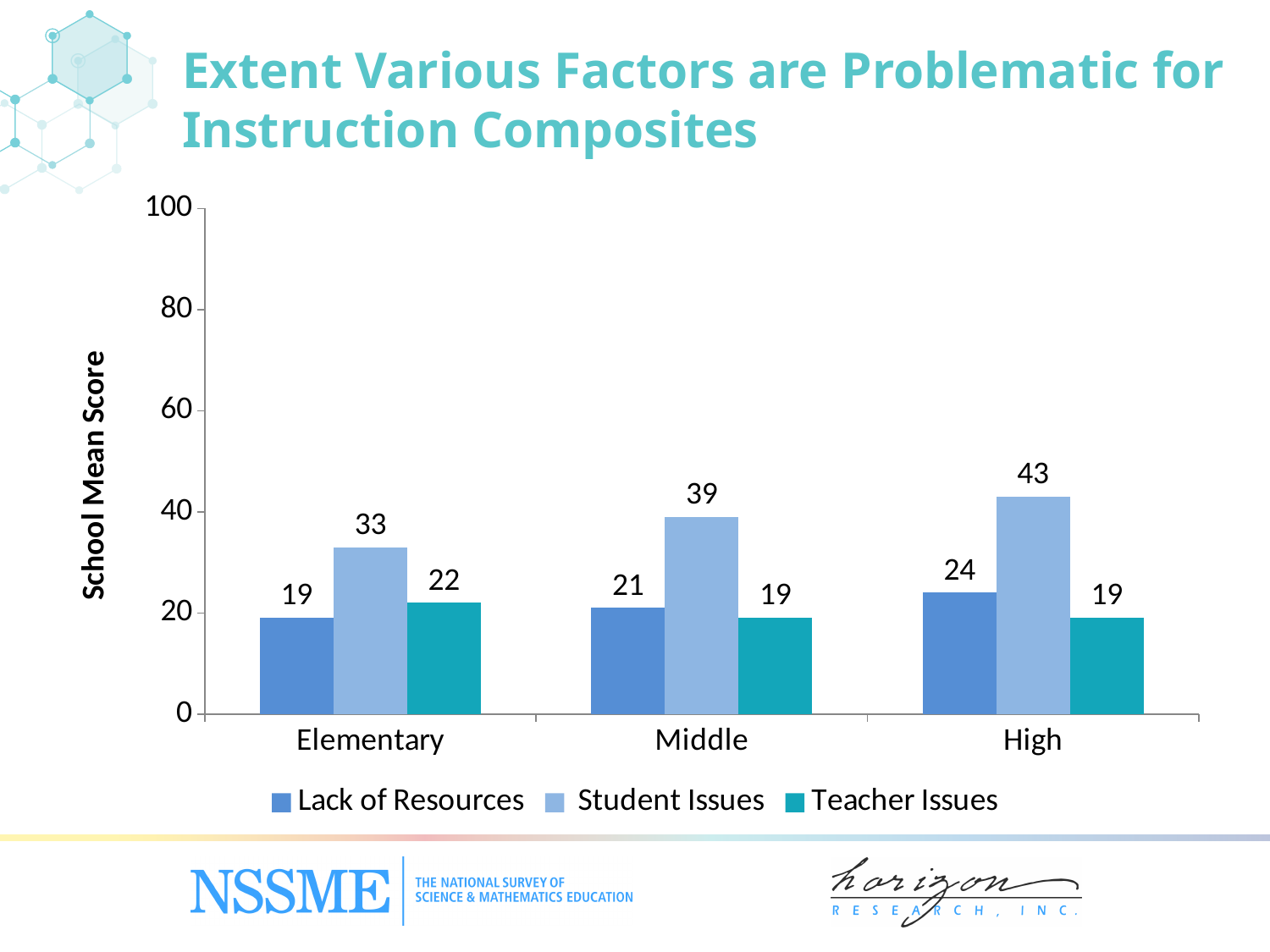
What is the Lack of Resources score for High schools? 24 What is the Teacher Issues score for Elementary schools? 22 How many series does the legend list? 3 What is the Student Issues score for Middle schools? 39 Which school level has the lowest Lack of Resources score? Elementary What is the difference between the Student Issues score and the Lack of Resources score for High schools? 19 Which school level has the highest Student Issues score? High Is the Student Issues score for High schools greater or less than 40? greater How many school levels are shown on the x axis? 3 What kind of chart is shown on the slide? Bar chart Which is larger for Elementary schools: the Student Issues score or the Teacher Issues score? Student Issues Does the Student Issues score rise or fall from Elementary to High? Rise